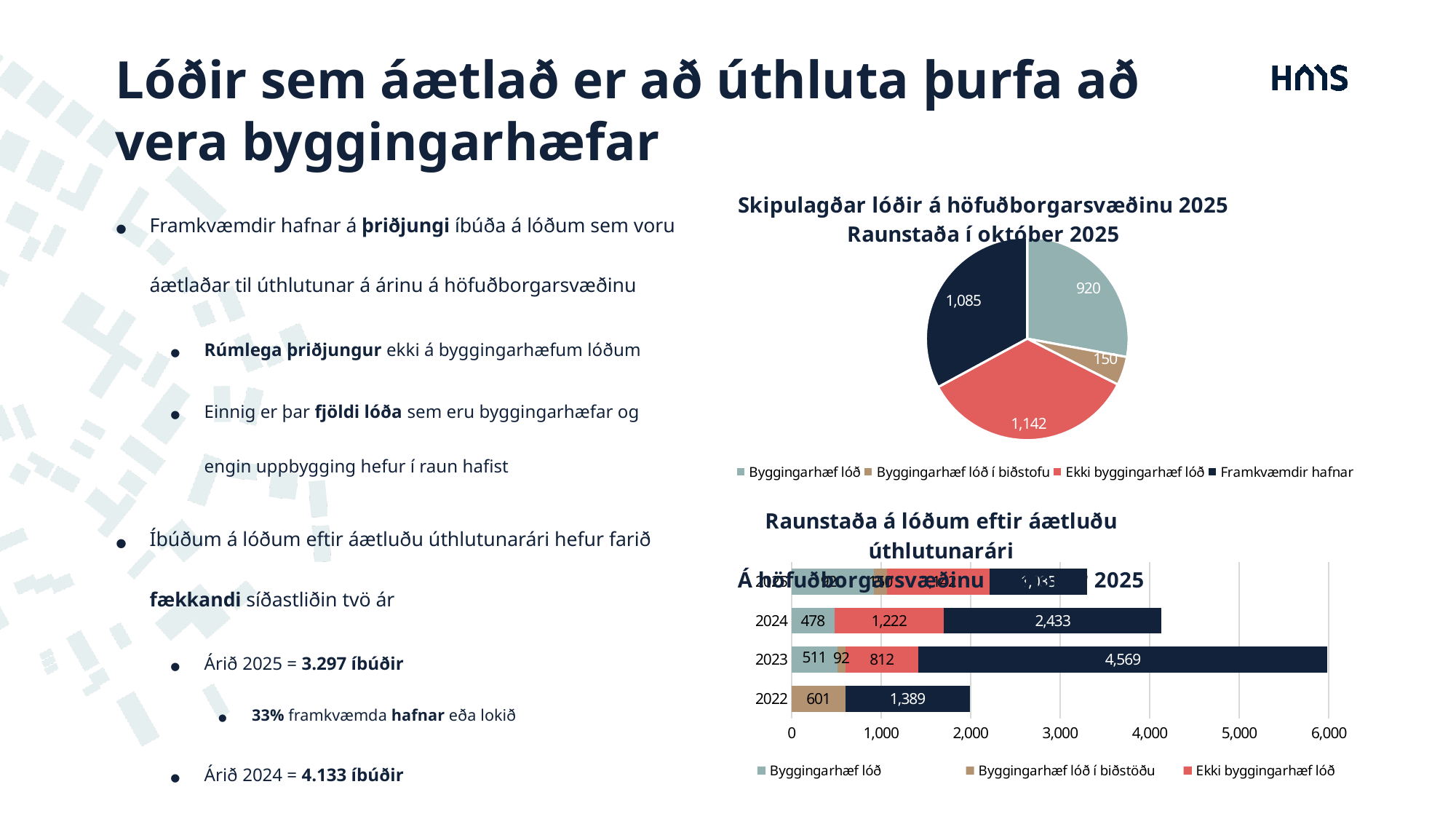
In the bar chart 'Raunstaða á lóðum eftir áætluðu úthlutunarári', what is the total of the 2024 bar? 4,133 In the pie chart 'Skipulagðar lóðir á höfuðborgarsvæðinu 2025', how many slices are there? 4 In the bar chart 'Raunstaða á lóðum eftir áætluðu úthlutunarári', what is the value for Byggingarhæf lóð í biðstöðu in 2023? 92 In the pie chart 'Skipulagðar lóðir á höfuðborgarsvæðinu 2025', which category has the largest slice? Ekki byggingarhæf lóð In the bar chart 'Raunstaða á lóðum eftir áætluðu úthlutunarári', which year has the longest bar? 2023 In the bar chart 'Raunstaða á lóðum eftir áætluðu úthlutunarári', what is the total of the 2022 bar? 1,990 In the pie chart 'Skipulagðar lóðir á höfuðborgarsvæðinu 2025', what is the difference between Ekki byggingarhæf lóð and Byggingarhæf lóð? 222 In the pie chart 'Skipulagðar lóðir á höfuðborgarsvæðinu 2025', which category has the smallest slice? Byggingarhæf lóð í biðstofu In the pie chart 'Skipulagðar lóðir á höfuðborgarsvæðinu 2025', what is the value for Ekki byggingarhæf lóð? 1,142 In the bar chart 'Raunstaða á lóðum eftir áætluðu úthlutunarári', what is the value for Ekki byggingarhæf lóð in 2024? 1,222 In the bar chart 'Raunstaða á lóðum eftir áætluðu úthlutunarári', is the total for 2023 greater or less than 5,000? greater What kind of chart is the lower chart 'Raunstaða á lóðum eftir áætluðu úthlutunarári'? Stacked bar chart